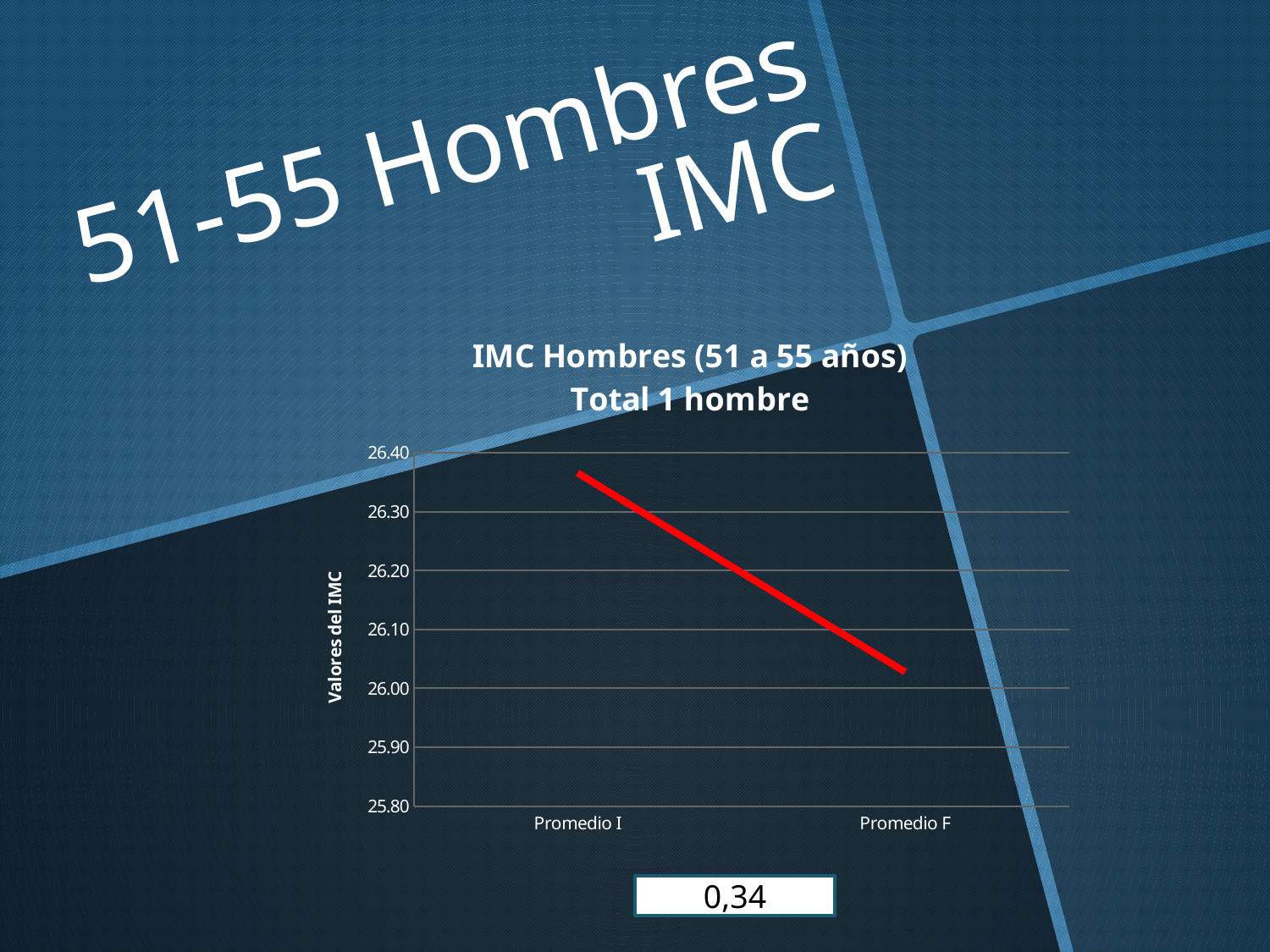
Is the value for Promedio I greater or less than 26.40? less Is the value for Promedio F greater or less than 26.00? greater How many categories are plotted on the x axis of the chart? 2 Do the values rise or fall from Promedio I to Promedio F? fall What kind of chart is shown on the slide? line chart Which is larger, the value for Promedio I or the value for Promedio F? Promedio I What is the label of the vertical axis of the chart? Valores del IMC Which category has the highest value, Promedio I or Promedio F? Promedio I What is the title of the chart? IMC Hombres (51 a 55 años) Total 1 hombre Which category has the lowest value on the chart? Promedio F Is the value for Promedio I greater or less than 26.30? greater